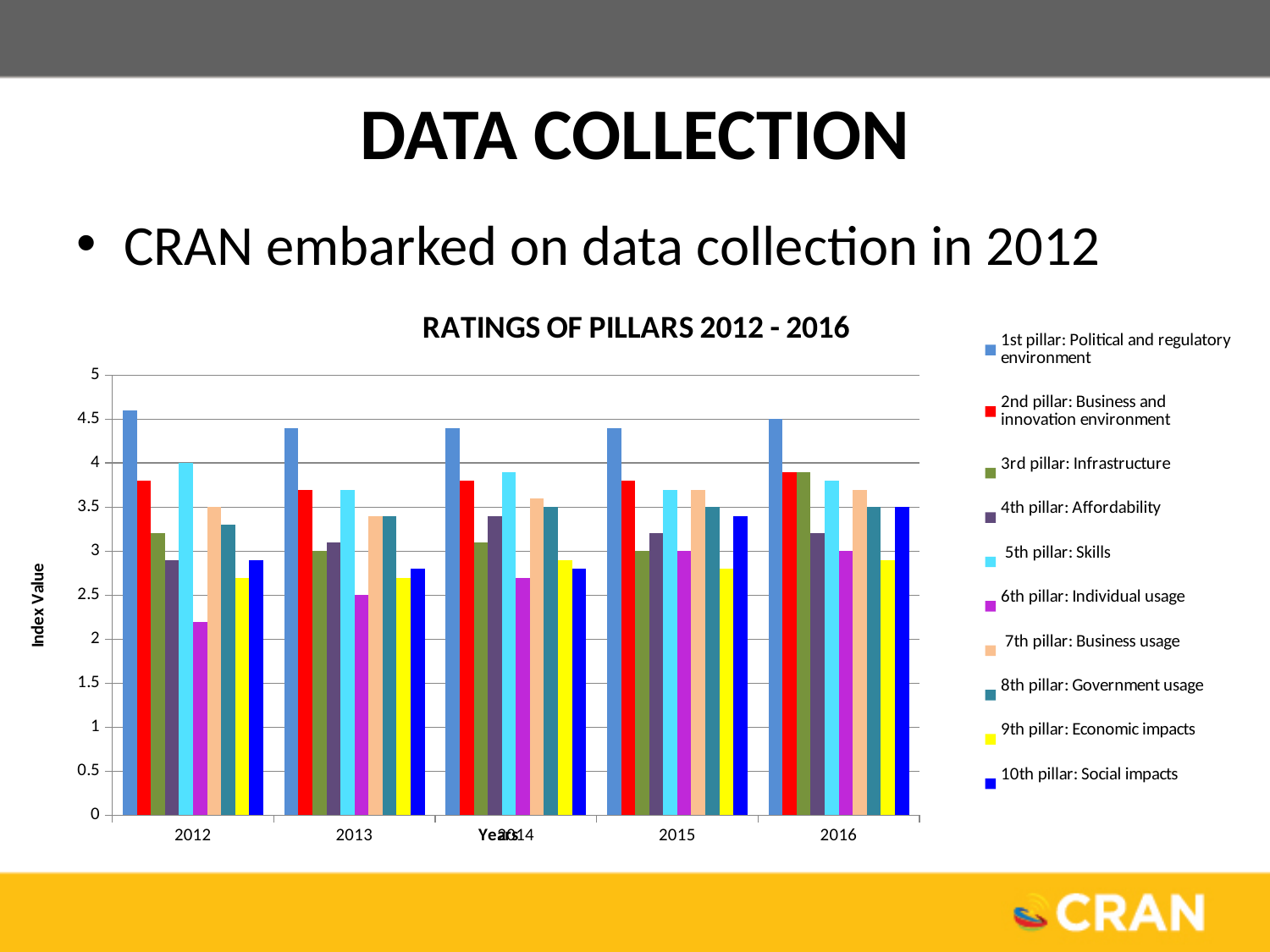
Is the value for the 6th pillar: Individual usage in 2013 greater or less than 3? less How many series does the legend of the chart list? 10 Which pillar has the highest rating in 2016? 1st pillar: Political and regulatory environment Is the value for the 1st pillar: Political and regulatory environment in 2012 greater or less than 4? greater In 2012, which is larger: the 2nd pillar: Business and innovation environment or the 3rd pillar: Infrastructure? 2nd pillar: Business and innovation environment What kind of chart is shown on the slide? Bar chart How many years are shown on the x axis of the chart? 5 Which pillar has the lowest rating in 2012? 6th pillar: Individual usage Is the value for the 10th pillar: Social impacts in 2016 greater or less than 3? greater Does the rating for the 6th pillar: Individual usage rise or fall from 2012 to 2016? Rise Which pillar has the highest rating in 2012? 1st pillar: Political and regulatory environment What is the title of the chart? RATINGS OF PILLARS 2012 - 2016